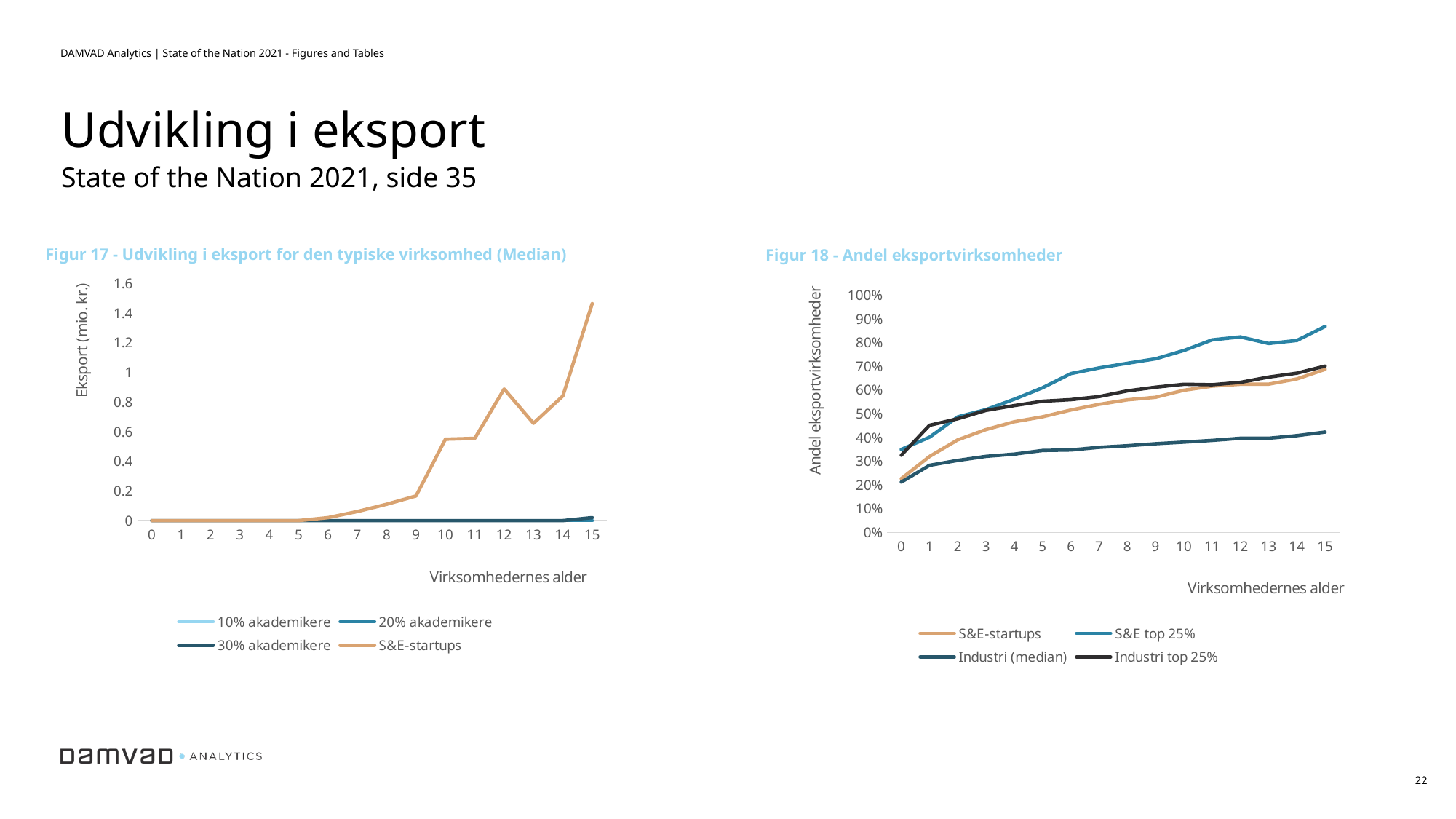
In Figur 18, which series has the lowest value at age 15? Industri (median) How many series does the legend of Figur 17 list? 4 How many series does the legend of Figur 18 - Andel eksportvirksomheder list? 4 In Figur 18, which series has the highest value at age 15? S&E top 25% In Figur 18, is the value for S&E top 25% at age 15 greater or less than 80%? greater In Figur 17, is the value for S&E-startups at age 13 greater or less than 0.8? less In Figur 18, does the S&E top 25% series generally rise or fall as company age increases? rise What kind of chart is Figur 17 - Udvikling i eksport for den typiske virksomhed (Median)? line chart In Figur 17, is the value for S&E-startups at age 15 greater or less than 1.2? greater In Figur 17, what is the label of the y axis? Eksport (mio. kr.) In Figur 17, which series has the highest value at age 15? S&E-startups How many age points are shown on the x axis of Figur 18? 16